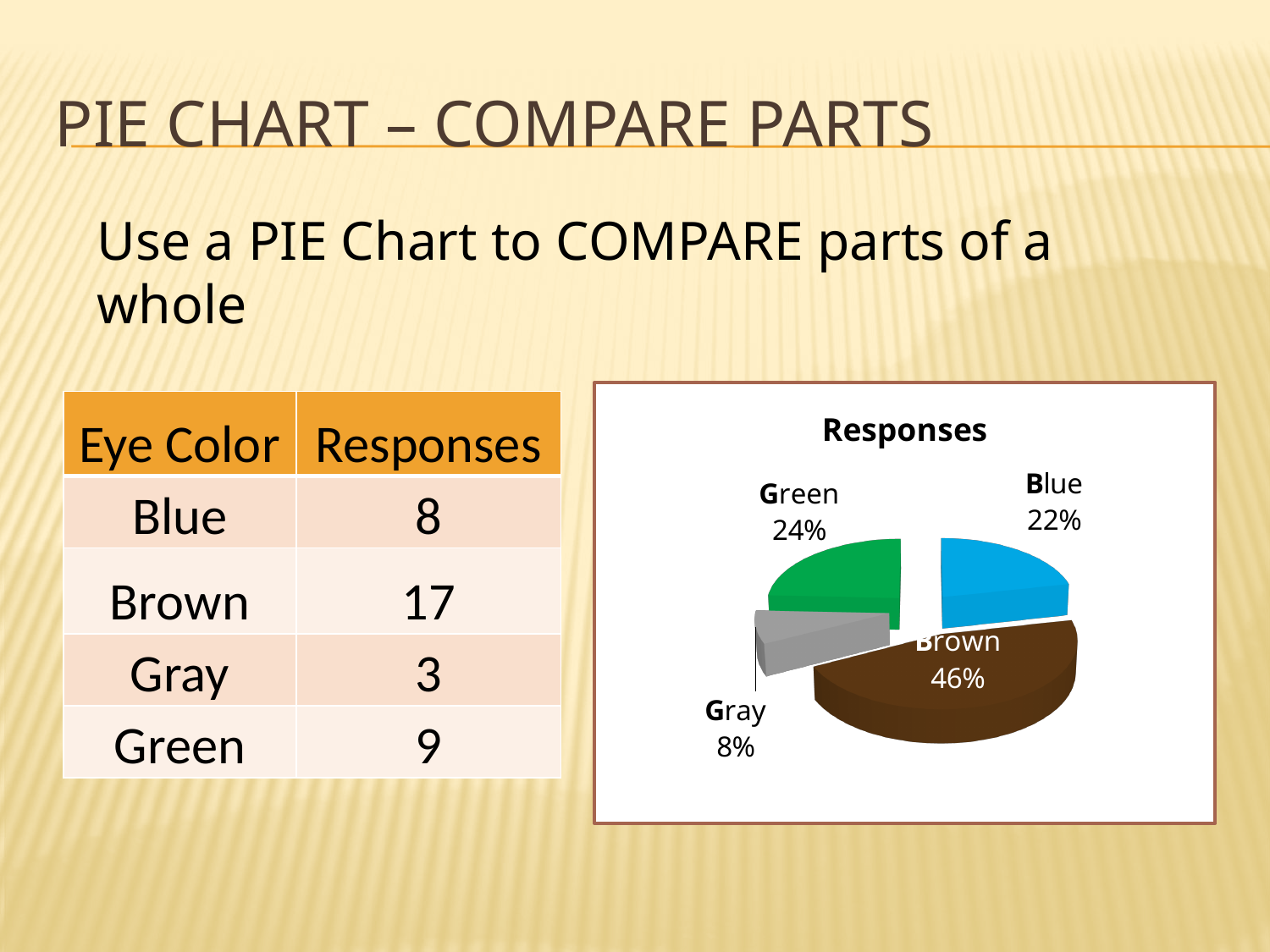
Which eye color has the smallest slice in the pie chart? Gray What is the difference in percentage points between the Brown and Blue slices? 24 How many slices does the pie chart have? 4 What percentage of the pie chart does Gray represent? 8% What percentage of the pie chart does Brown represent? 46% What is the title of the pie chart? Responses What percentage of the pie chart does Blue represent? 22% Which slice is larger in the pie chart, Green or Blue? Green What colour is the Gray slice drawn in on the pie chart? Gray What kind of chart is shown on the slide? Pie chart Which eye color has the largest slice in the pie chart? Brown